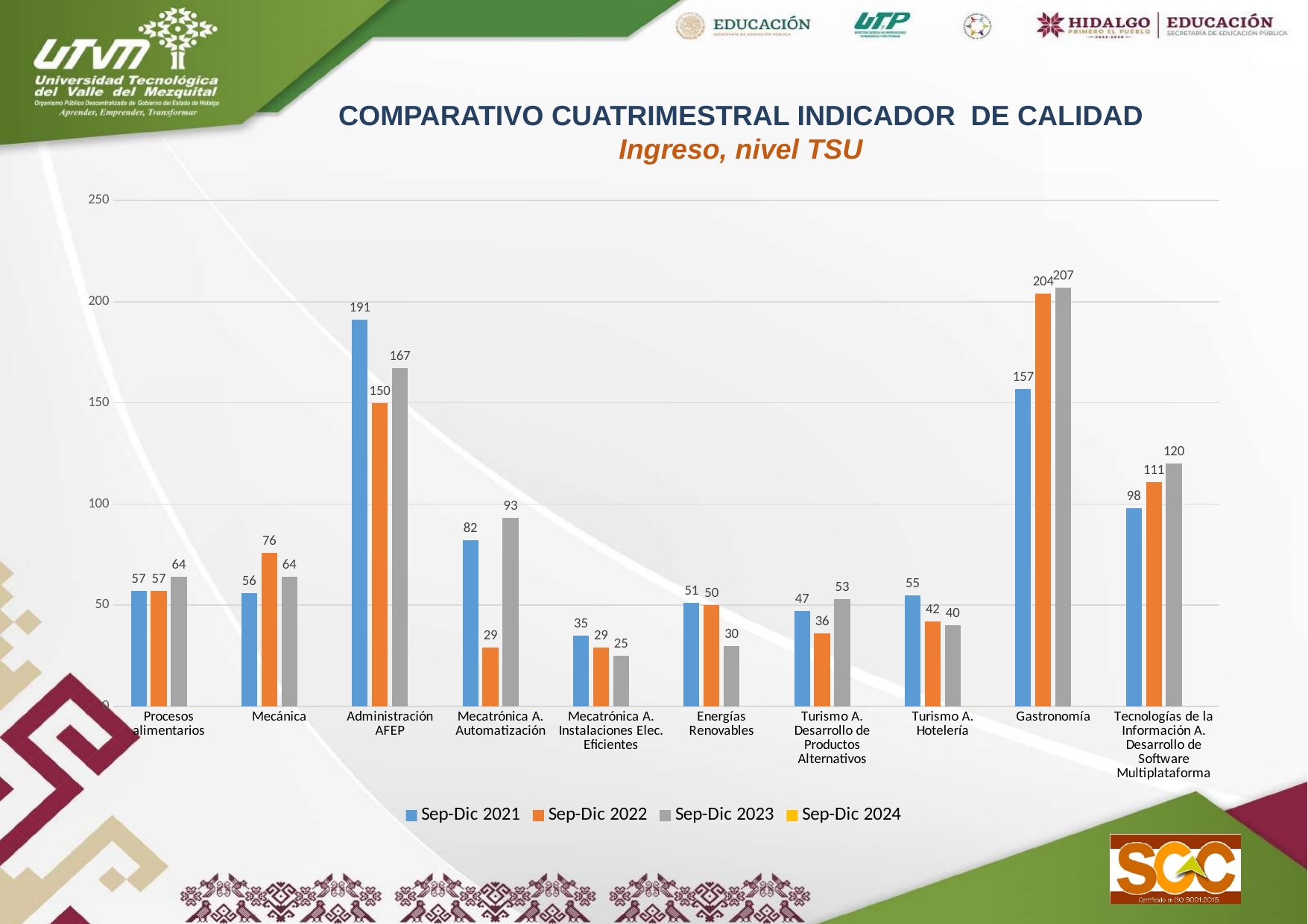
Which category has the highest Sep-Dic 2022 value? Gastronomía What is the Sep-Dic 2021 value for Administración AFEP? 191 What type of chart is shown on the slide? bar chart How many program categories are shown on the x axis? 10 Which category has the lowest Sep-Dic 2023 value? Mecatrónica A. Instalaciones Elec. Eficientes What is the Sep-Dic 2023 value for Gastronomía? 207 Do the values for Tecnologías de la Información A. Desarrollo de Software Multiplataforma rise or fall from Sep-Dic 2021 to Sep-Dic 2023? rise What is the Sep-Dic 2022 value for Mecatrónica A. Automatización? 29 For Turismo A. Hotelería, which is larger: the Sep-Dic 2021 value or the Sep-Dic 2023 value? Sep-Dic 2021 How many series does the legend list? 4 What is the difference between the Sep-Dic 2021 and Sep-Dic 2022 values for Administración AFEP? 41 What is the subtitle of the chart shown in orange italics? Ingreso, nivel TSU